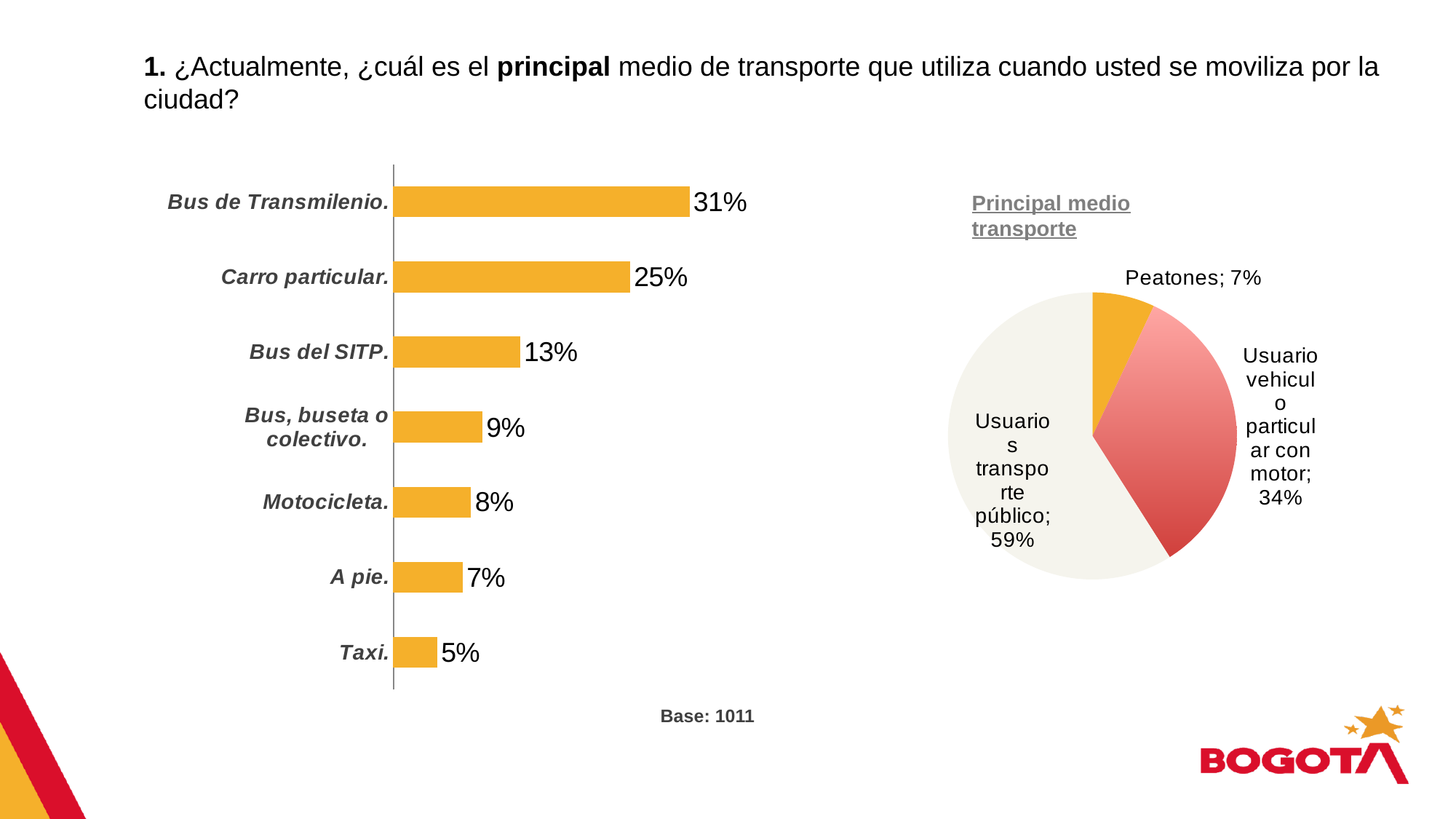
In the pie chart 'Principal medio transporte', what share is Usuarios transporte público? 59% How many slices does the pie chart 'Principal medio transporte' have? 3 In the bar chart on the left, which category has the highest value? Bus de Transmilenio How many categories does the bar chart on the left show? 7 In the bar chart on the left, what is the value for Bus de Transmilenio? 31% What kind of chart is the chart on the left? Bar chart In the bar chart on the left, what is the difference between Bus de Transmilenio and Carro particular? 6% In the pie chart 'Principal medio transporte', what share is Peatones? 7% In the bar chart on the left, which category has the lowest value? Taxi In the bar chart on the left, what is the value for Carro particular? 25% In the pie chart 'Principal medio transporte', which slice is the largest? Usuarios transporte público In the bar chart on the left, which is larger: Bus del SITP or Motocicleta? Bus del SITP